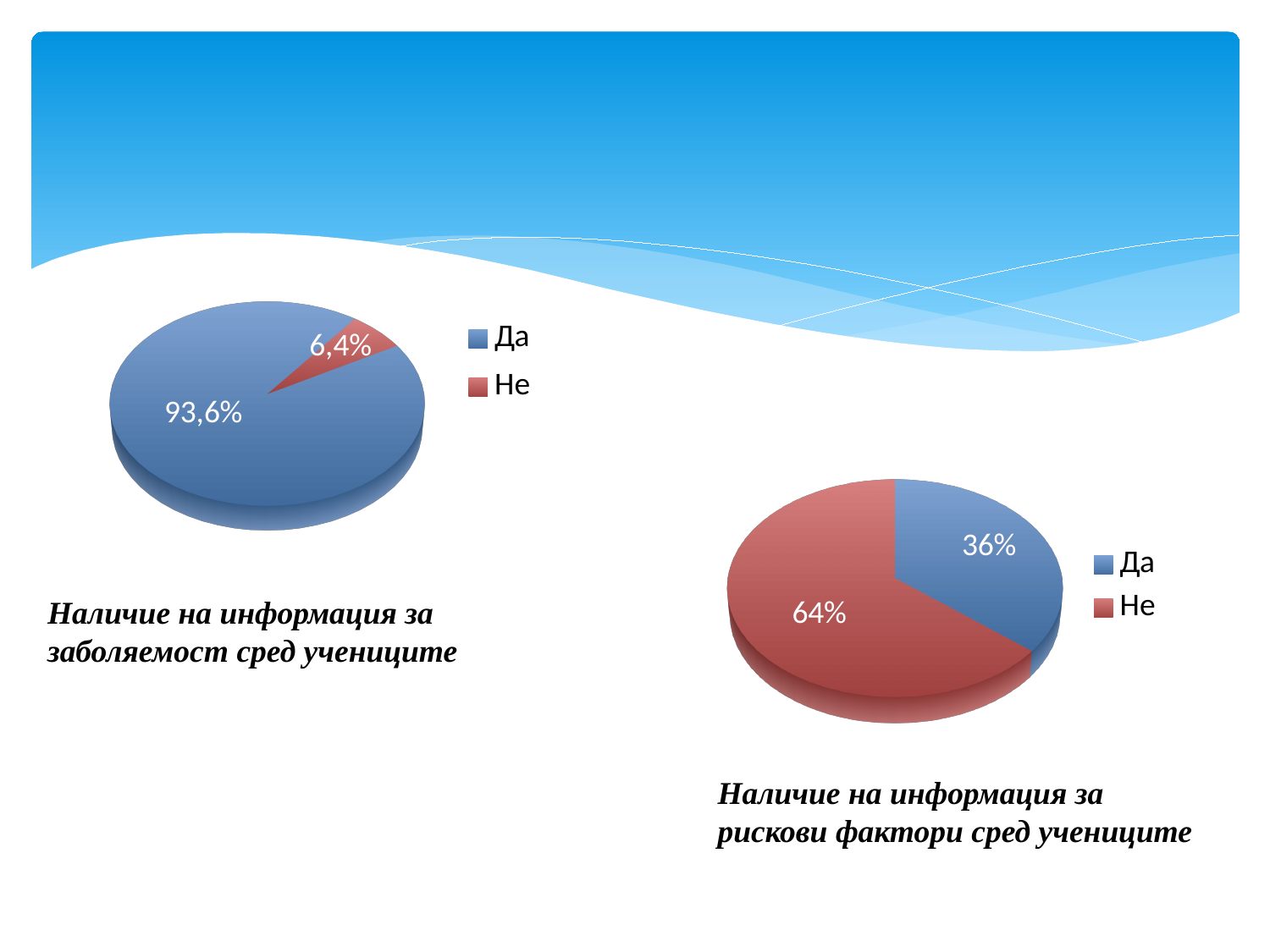
In the left pie chart (Наличие на информация за заболяемост сред учениците), what is the difference between the Да and Не shares? 87,2% In the right pie chart (Наличие на информация за рискови фактори сред учениците), which category has the smallest share? Да In the right pie chart (Наличие на информация за рискови фактори сред учениците), which is larger, Да or Не? Не In the right pie chart (Наличие на информация за рискови фактори сред учениците), what is the value for Да? 36% In the right pie chart (Наличие на информация за рискови фактори сред учениците), what is the value for Не? 64% In the left pie chart (Наличие на информация за заболяемост сред учениците), what is the value for Не? 6,4% In the right pie chart (Наличие на информация за рискови фактори сред учениците), what is the difference between the Не and Да shares? 28% What type of chart is the left chart (Наличие на информация за заболяемост сред учениците)? Pie chart In the left pie chart (Наличие на информация за заболяемост сред учениците), what is the value for Да? 93,6% How many categories does the legend of the right pie chart (Наличие на информация за рискови фактори сред учениците) list? 2 In the left pie chart (Наличие на информация за заболяемост сред учениците), what colour is the Не slice? Red In the left pie chart (Наличие на информация за заболяемост сред учениците), which category has the largest share? Да